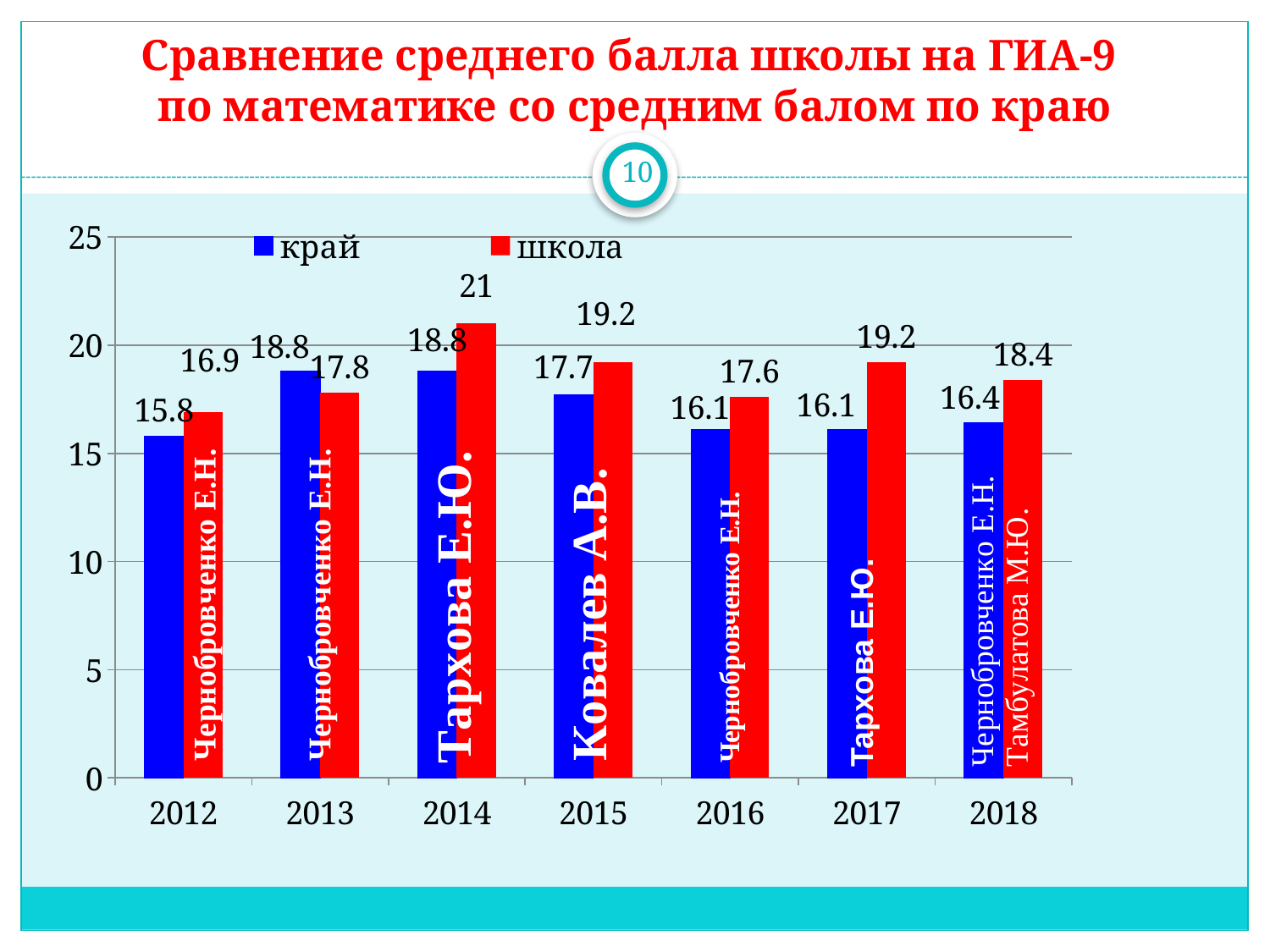
What is the value for край in 2012? 15.8 In which year is the край value lowest? 2012 What kind of chart is shown on the slide? bar chart How many years are shown on the x axis? 7 In which year is the школа value highest? 2014 What is the value for школа in 2018? 18.4 Is the value for школа in 2014 greater or less than 20? greater What is the difference between the школа and край values in 2017? 3.1 What is the value for край in 2015? 17.7 Which is larger in 2013, the край value or the школа value? край How many series does the legend list? 2 What is the value for школа in 2014? 21